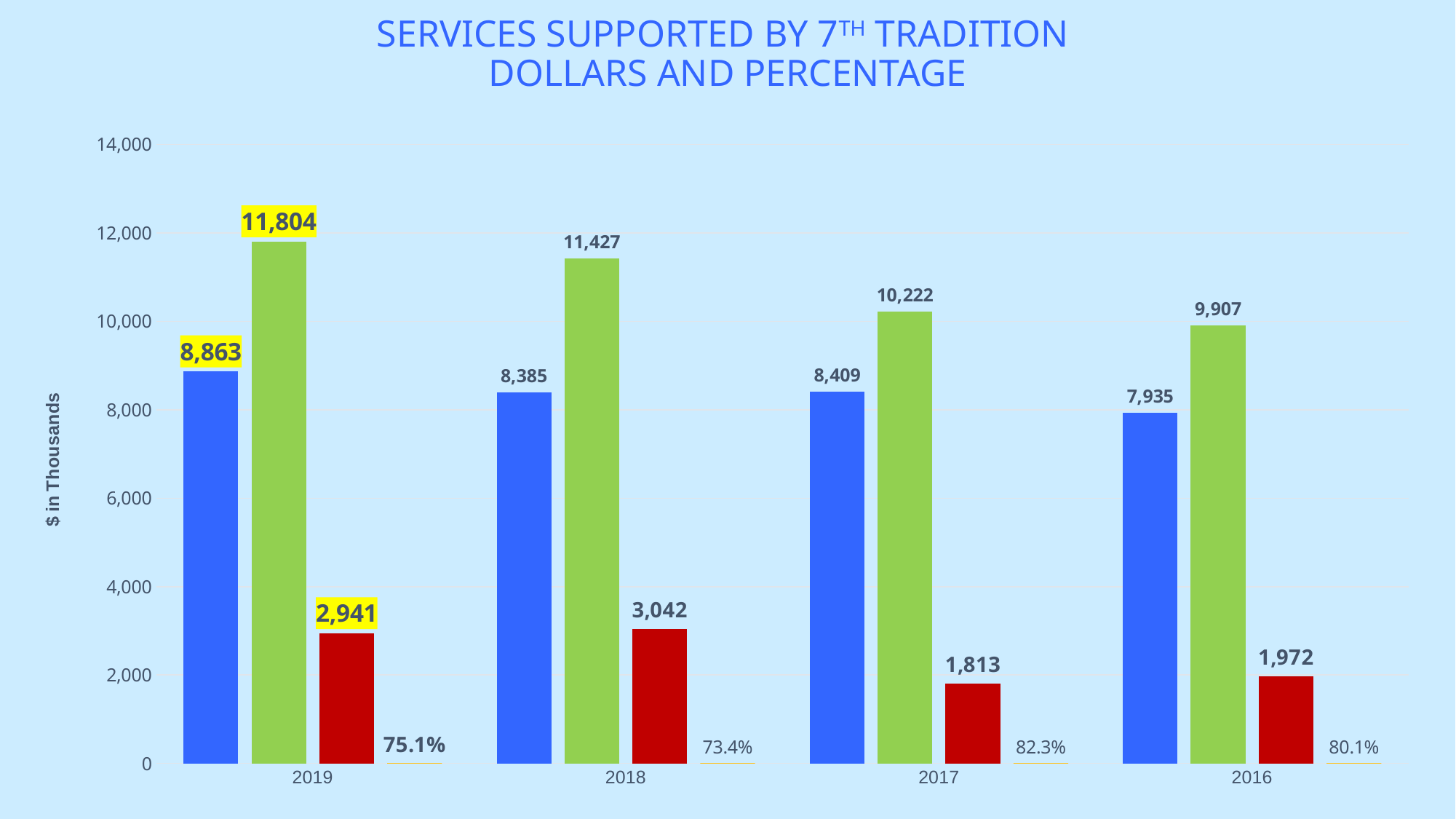
What kind of chart is shown on the slide? bar chart Which year has the highest green bar? 2019 What is the value of the green bar for 2019? 11,804 Is the value of the red bar for 2016 greater or less than 4,000? less How many years are shown on the x axis? 4 What is the value of the blue bar for 2016? 7,935 Which is larger, the blue bar for 2018 or the blue bar for 2017? 2017 What is the label on the vertical axis? $ in Thousands What is the difference between the green bar and the blue bar for 2019? 2,941 What is the value of the red bar for 2018? 3,042 What percentage is shown for 2017? 82.3% Which year has the lowest red bar? 2017